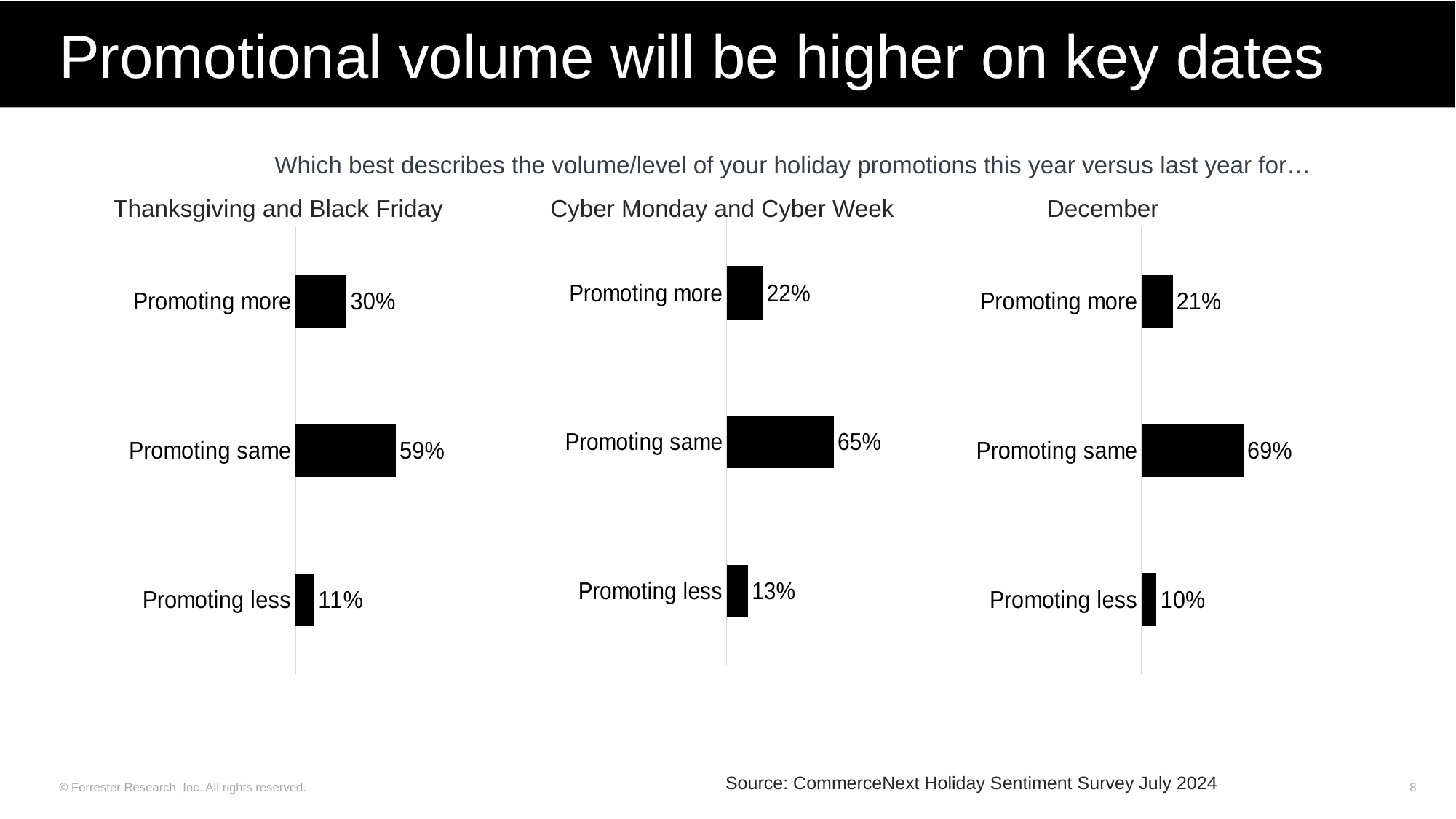
In the Thanksgiving and Black Friday chart, which category has the lowest value? Promoting less What type of chart is the December chart? Bar chart Which is larger: the Promoting more value in the Thanksgiving and Black Friday chart or the Promoting more value in the December chart? Thanksgiving and Black Friday In the Thanksgiving and Black Friday chart, what percentage of respondents are promoting more? 30% In the December chart, what percentage of respondents are promoting less? 10% What is the title of the middle chart on the slide? Cyber Monday and Cyber Week How many charts are shown on the slide? 3 In the Cyber Monday and Cyber Week chart, what is the difference between the Promoting more and Promoting less values? 9% In the Thanksgiving and Black Friday chart, what is the difference between the Promoting same and Promoting more values? 29% How many categories does the Cyber Monday and Cyber Week chart show? 3 In the Cyber Monday and Cyber Week chart, what percentage of respondents are promoting same? 65% In the December chart, which category has the highest value? Promoting same